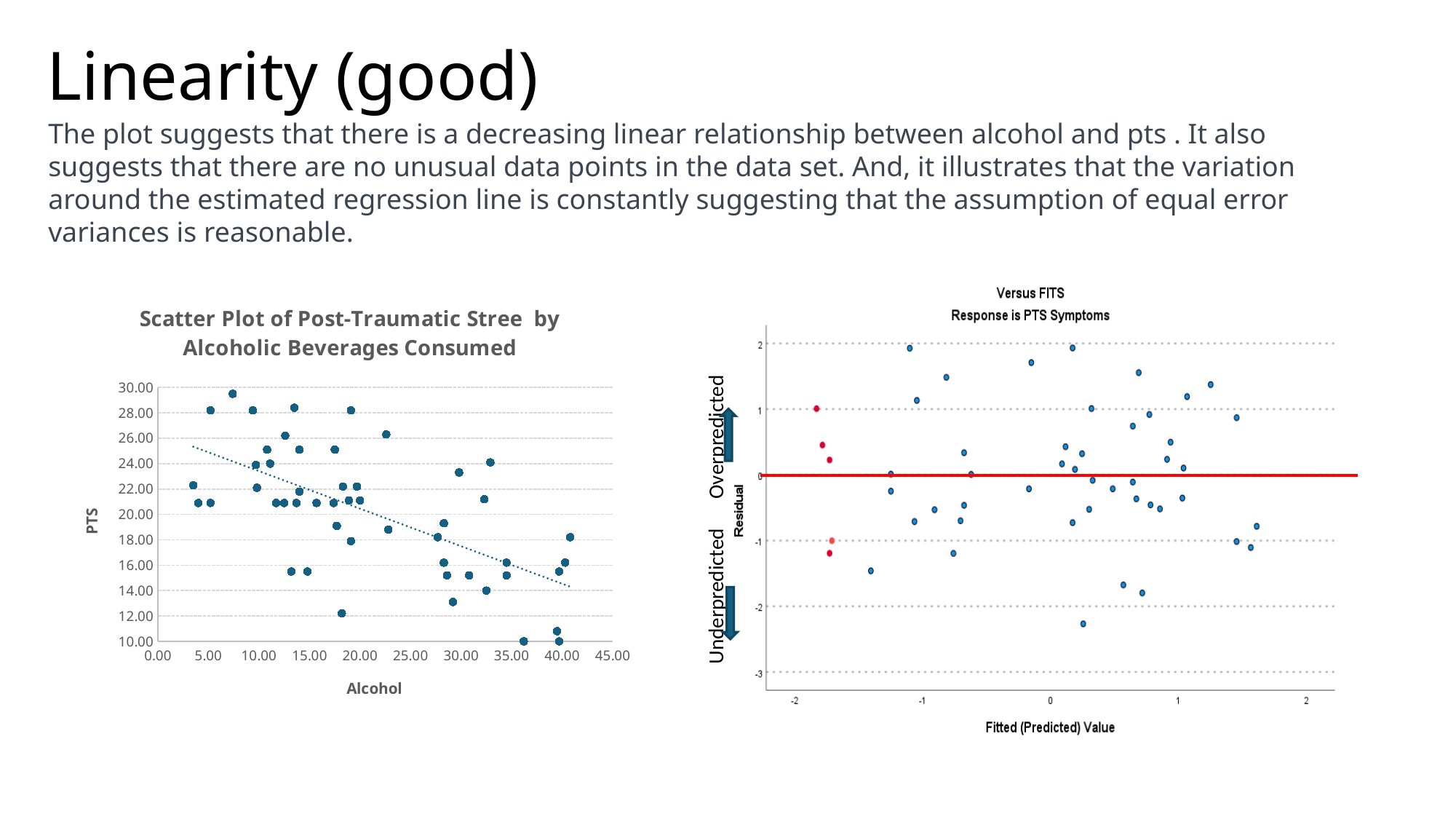
In the left scatter plot, is the highest PTS value plotted greater or less than 28.00? greater In the right chart 'Versus FITS', is the lowest residual plotted greater or less than -2? less In the right chart 'Versus FITS', is the highest residual plotted greater or less than 1? greater What kind of chart is the right chart, 'Versus FITS'? scatter plot What is the x-axis title of the left scatter plot? Alcohol What is the x-axis title of the right chart 'Versus FITS'? Fitted (Predicted) Value In the left scatter plot, do PTS values generally rise or fall as Alcohol increases along the x axis? fall What kind of chart is the left chart, 'Scatter Plot of Post-Traumatic Stree by Alcoholic Beverages Consumed'? scatter plot